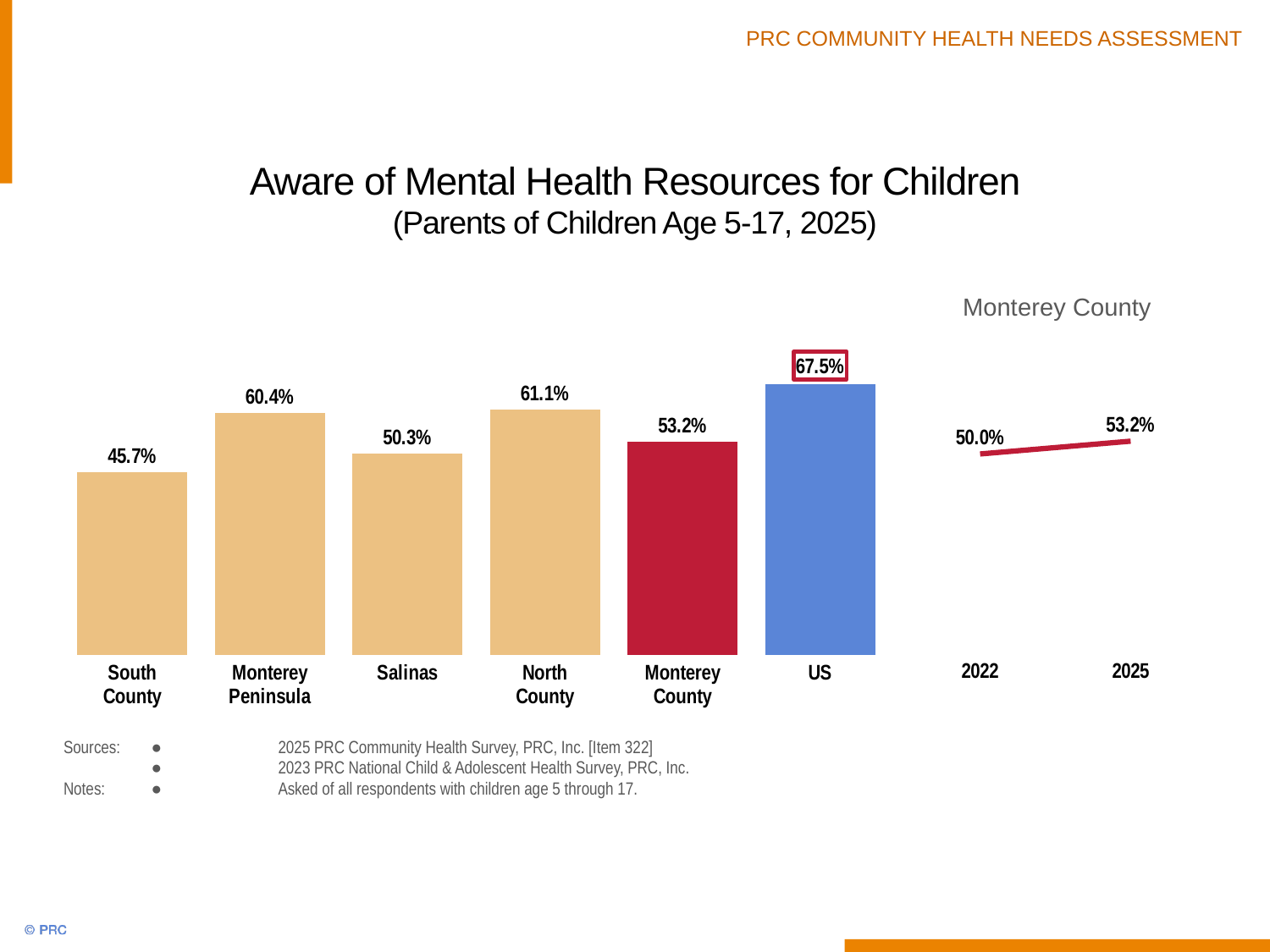
In the Monterey County trend chart on the right, what is the difference between the 2025 and 2022 values? 3.2 percentage points In the bar chart, what is the value for North County? 61.1% In the bar chart, which category has the lowest value? South County In the bar chart, which category has the highest value? US How many categories are shown in the bar chart? 6 In the Monterey County trend chart on the right, does the value rise or fall from 2022 to 2025? Rise In the bar chart, which is larger, the value for Monterey Peninsula or the value for Salinas? Monterey Peninsula What kind of chart is the chart on the left? Bar chart In the Monterey County trend chart on the right, what is the value for 2022? 50.0% In the bar chart, what is the value for the US? 67.5% In the bar chart, what is the value for South County? 45.7% In the bar chart, what is the difference between the US value and the Monterey County value? 14.3 percentage points